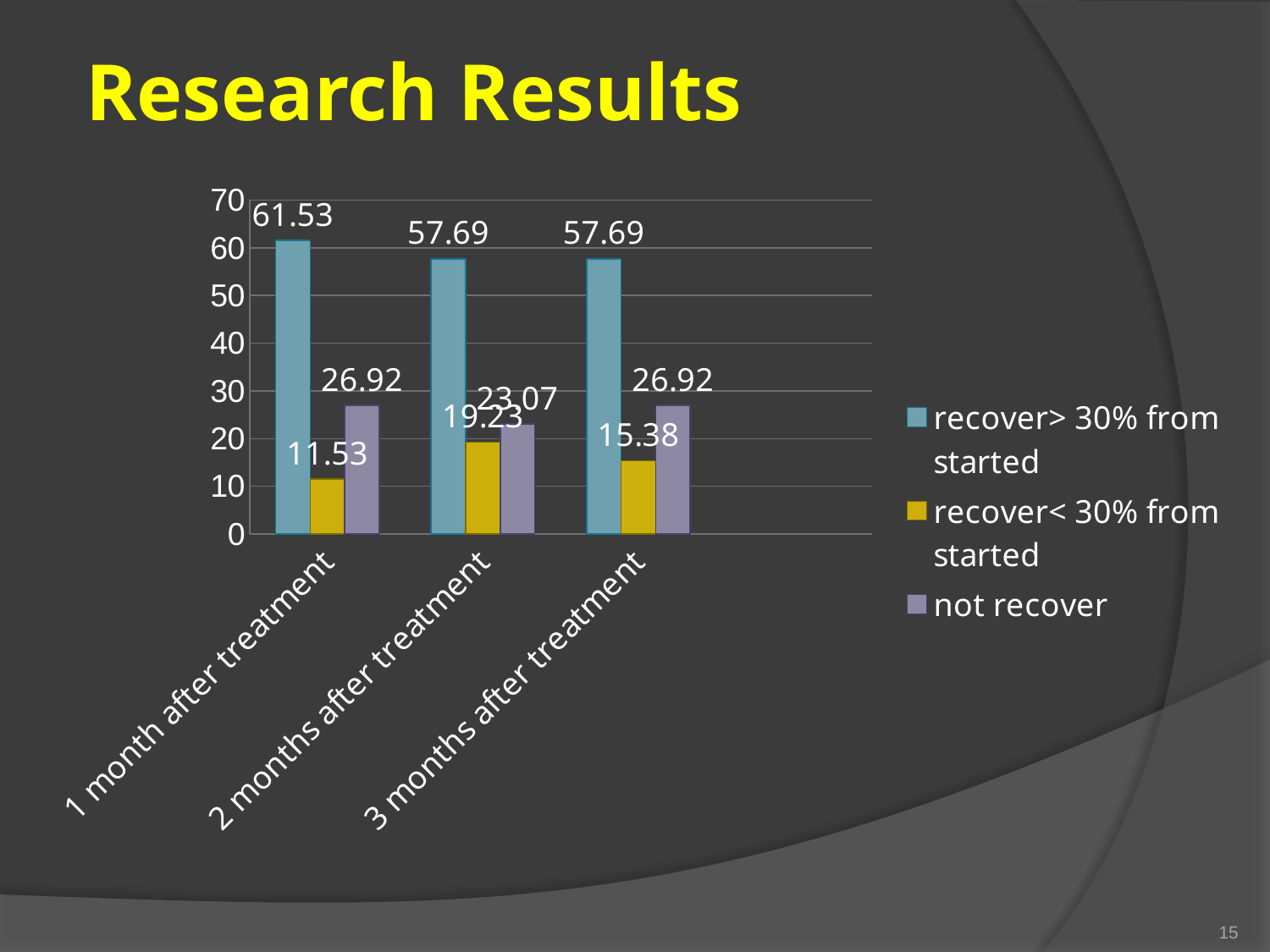
At 2 months after treatment, which is larger: "recover< 30% from started" or "not recover"? not recover Is the value for "not recover" at 2 months after treatment greater or less than 30? less What is the difference between the "recover> 30% from started" values at 1 month and 2 months after treatment? 3.84 How many categories are shown on the x axis? 3 What is the value for "recover< 30% from started" at 3 months after treatment? 15.38 What is the value for "recover< 30% from started" at 2 months after treatment? 19.23 What is the value for "not recover" at 3 months after treatment? 26.92 How many series does the legend list? 3 What kind of chart is shown on the slide? bar chart Which category has the lowest value for "recover< 30% from started"? 1 month after treatment Which category has the highest value for "recover> 30% from started"? 1 month after treatment What is the value for "recover> 30% from started" at 1 month after treatment? 61.53